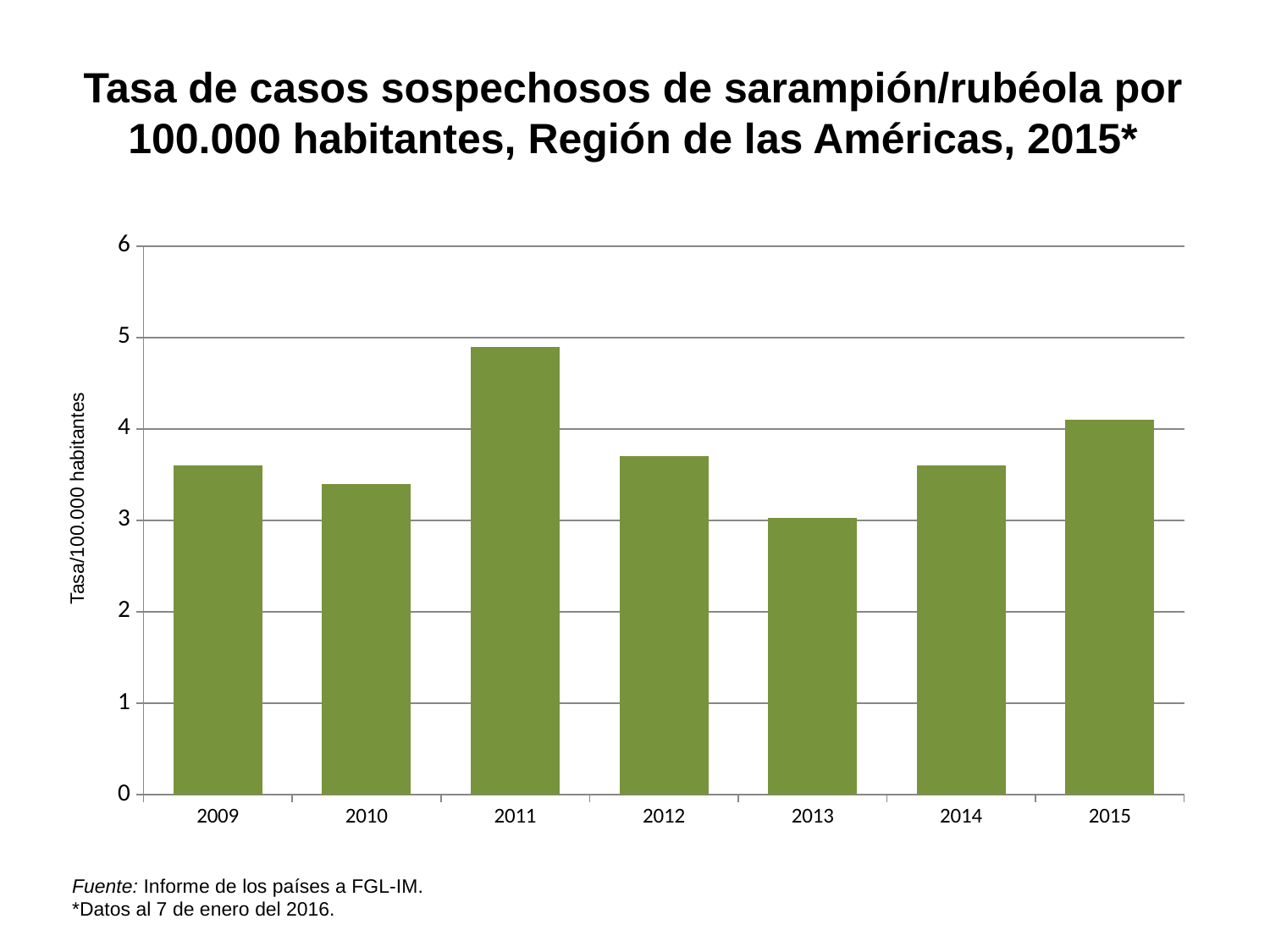
What kind of chart is shown on the slide? bar chart Which year has a higher rate, 2012 or 2013? 2012 Which year has the highest rate of suspected measles/rubella cases? 2011 What is the label on the y axis of the chart? Tasa/100.000 habitantes Is the value for 2015 greater or less than 5? less How many years are shown on the x axis of the chart? 7 Is the value for 2012 greater or less than 3? greater Which year has a higher rate, 2011 or 2015? 2011 Which year has the lowest rate of suspected measles/rubella cases? 2013 Is the value for 2011 greater or less than 4? greater Do the values rise or fall from 2013 to 2015? rise